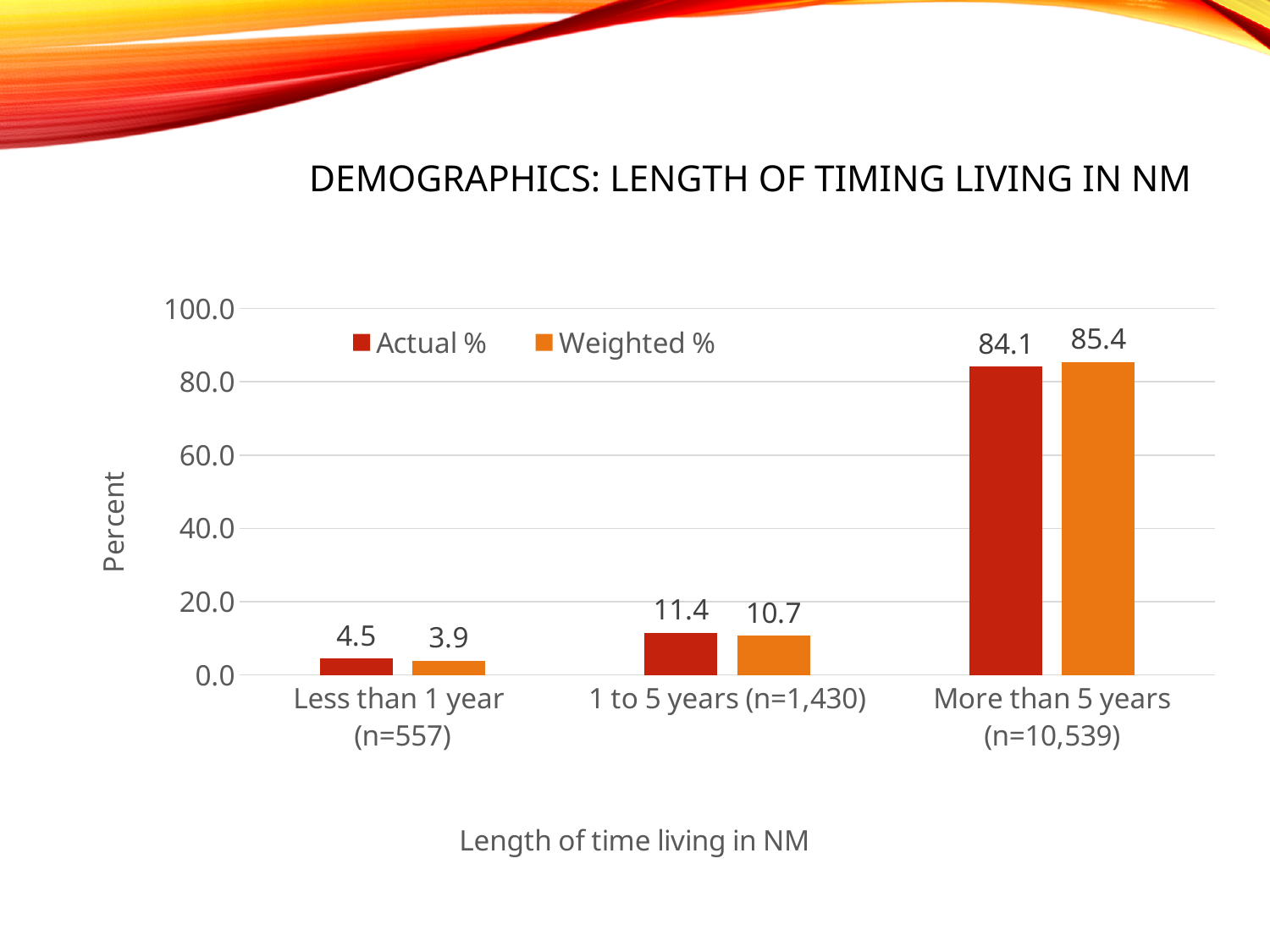
What is the Weighted % value for '1 to 5 years (n=1,430)'? 10.7 Which is larger for '1 to 5 years (n=1,430)': the Actual % or the Weighted % value? Actual % How many categories are shown on the x axis? 3 What is the Weighted % value for 'Less than 1 year (n=557)'? 3.9 Is the Actual % value for 'More than 5 years (n=10,539)' greater or less than 80.0? greater How many series does the legend list? 2 What kind of chart is shown on the slide? Bar chart What is the difference between the Weighted % and Actual % values for 'More than 5 years (n=10,539)'? 1.3 Which category has the lowest Weighted % value? Less than 1 year (n=557) What is the difference between the Actual % values for '1 to 5 years (n=1,430)' and 'Less than 1 year (n=557)'? 6.9 Which category has the highest Actual % value? More than 5 years (n=10,539) What is the Actual % value for 'More than 5 years (n=10,539)'? 84.1